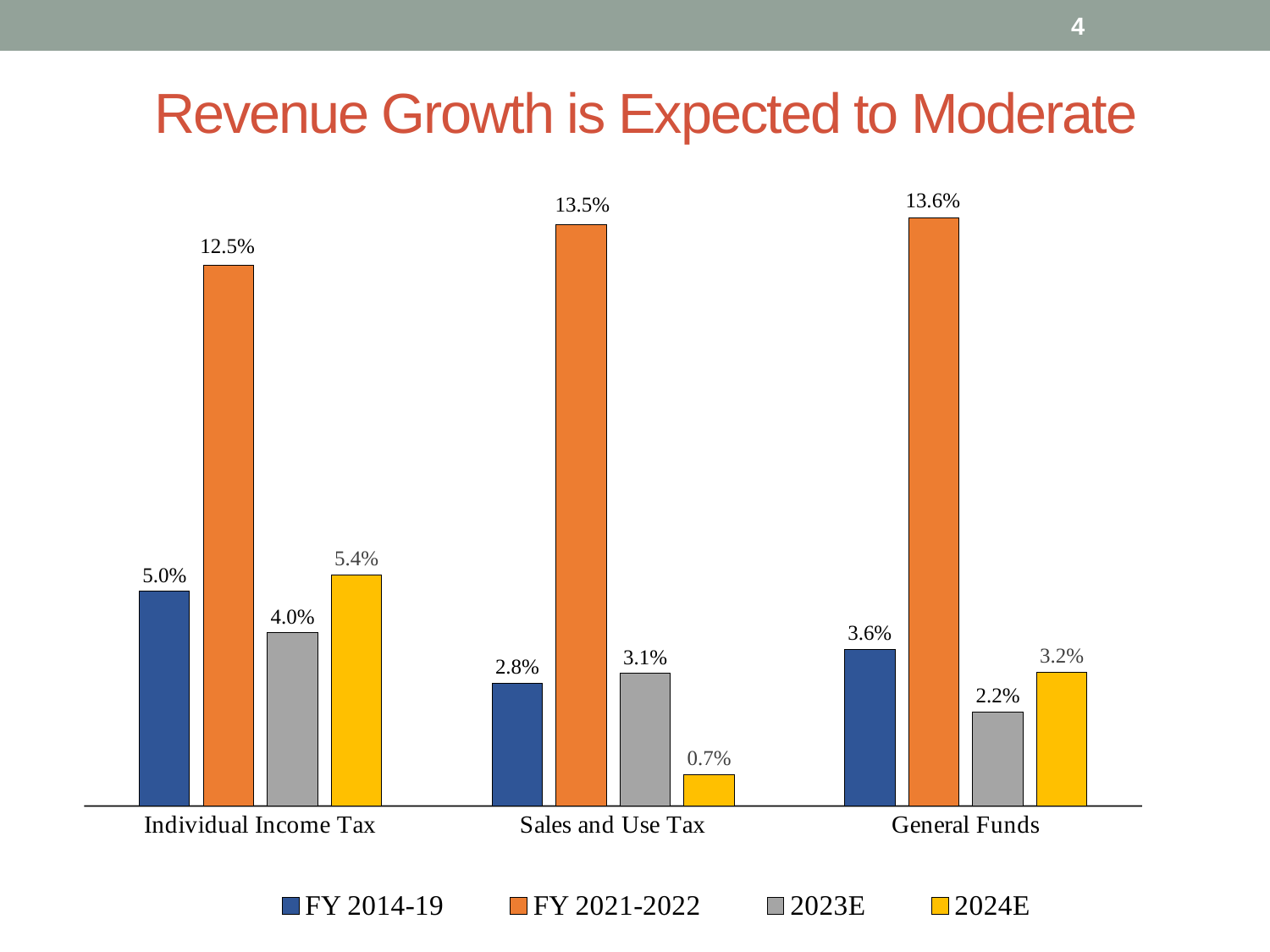
What is the 2023E value for General Funds? 2.2% What is the FY 2021-2022 value for Sales and Use Tax? 13.5% What is the 2024E value for Individual Income Tax? 5.4% Which category has the lowest 2024E value? Sales and Use Tax Which is larger for General Funds: the FY 2014-19 value or the 2024E value? FY 2014-19 What kind of chart is shown on the slide? Bar chart How many series does the legend list? 4 What is the title of the slide? Revenue Growth is Expected to Moderate Which category has the highest FY 2021-2022 value? General Funds What is the FY 2014-19 value for Sales and Use Tax? 2.8% What is the difference between the FY 2021-2022 and 2023E values for Individual Income Tax? 8.5% How many categories are shown on the x axis? 3